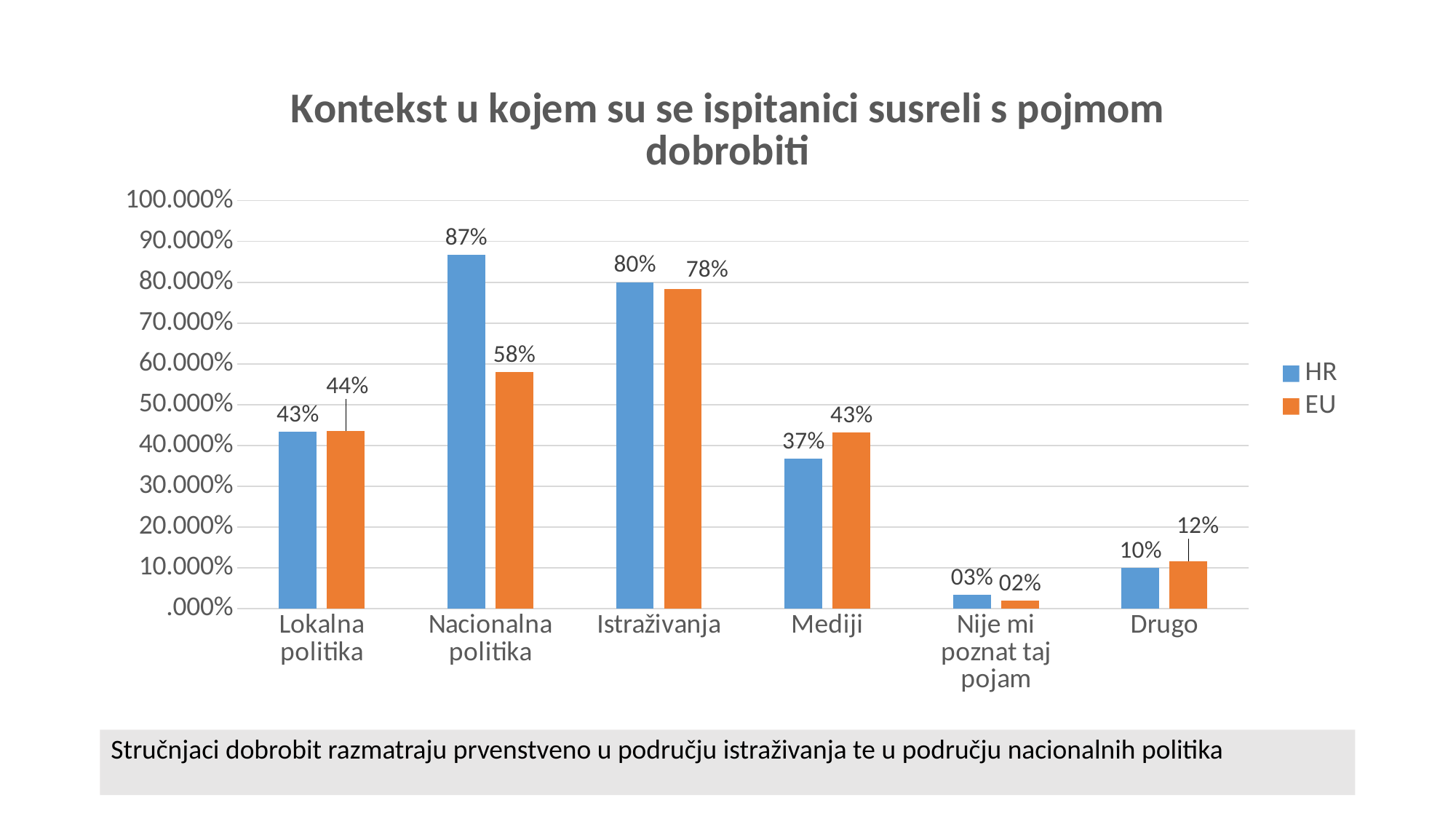
What kind of chart is shown on the slide? bar chart What is the EU value for Istraživanja? 78% Is the HR value for Istraživanja greater or less than 70.000%? greater How many series does the legend list? 2 Which is larger for Mediji, the HR value or the EU value? EU How many categories are shown on the x axis? 6 What is the EU value for Mediji? 43% What is the HR value for Drugo? 10% Which category has the highest HR value? Nacionalna politika What is the HR value for Nacionalna politika? 87% Which category has the lowest EU value? Nije mi poznat taj pojam What is the difference between the HR and EU values for Nacionalna politika? 29%